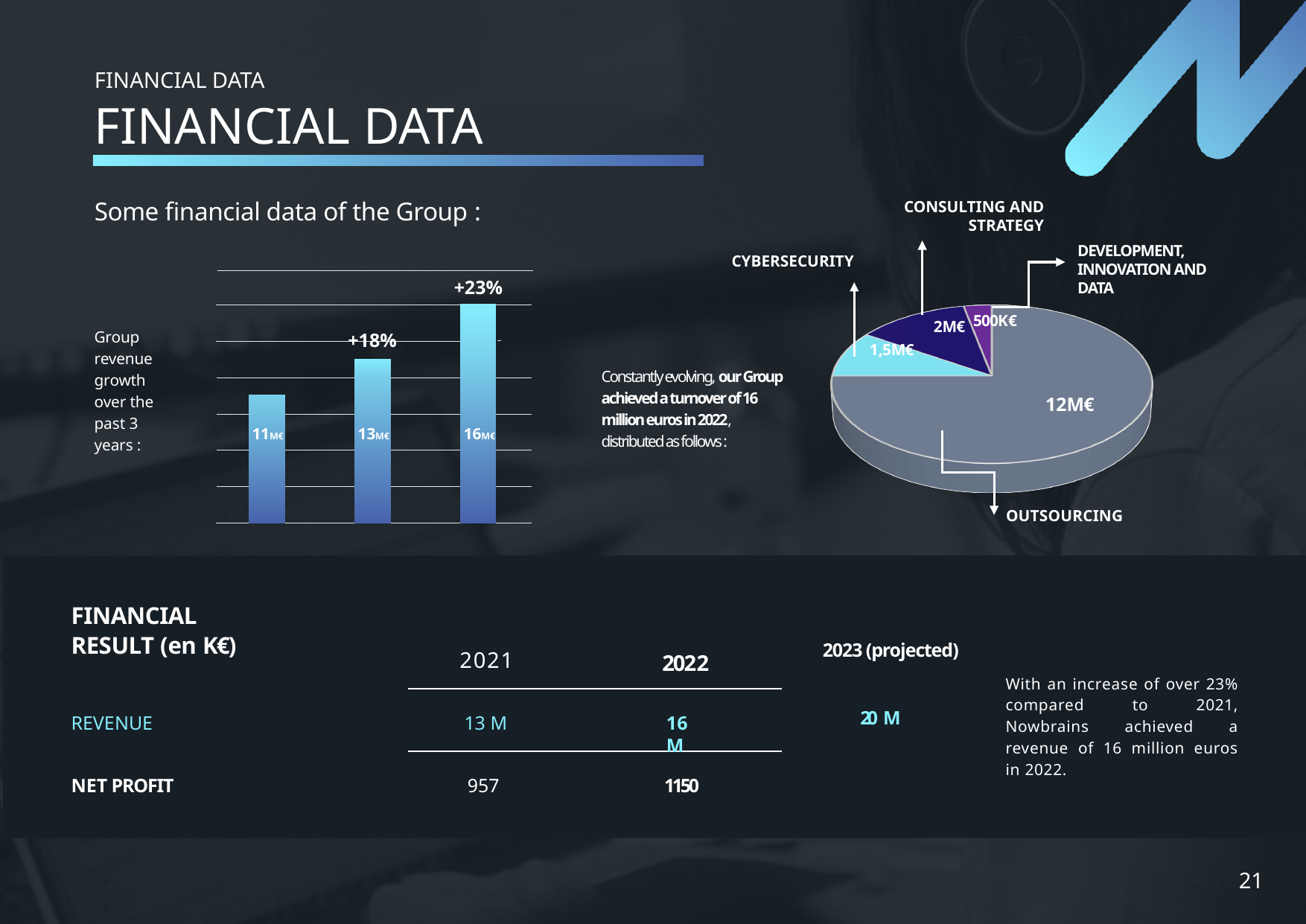
In the bar chart on the left, how many bars are plotted? 3 In the pie chart on the right, which segment is the smallest? Development, Innovation and Data In the bar chart on the left, what growth percentage is printed above the middle bar? +18% In the bar chart on the left, do the values rise or fall from left to right? rise In the pie chart on the right, which is larger, Cybersecurity or Consulting and Strategy? Consulting and Strategy In the bar chart on the left, what is the difference between the rightmost bar and the leftmost bar? 5M€ What kind of chart is the chart on the right showing the distribution of the 2022 turnover? pie chart In the bar chart on the left, what is the value of the tallest (rightmost) bar? 16M€ In the pie chart on the right, what share of the total turnover does the Outsourcing slice represent? 75% In the bar chart on the left, what is the value of the first (leftmost) bar? 11M€ In the pie chart on the right, what is the value of the Outsourcing slice? 12M€ What kind of chart is the chart on the left showing group revenue growth over the past 3 years? bar chart